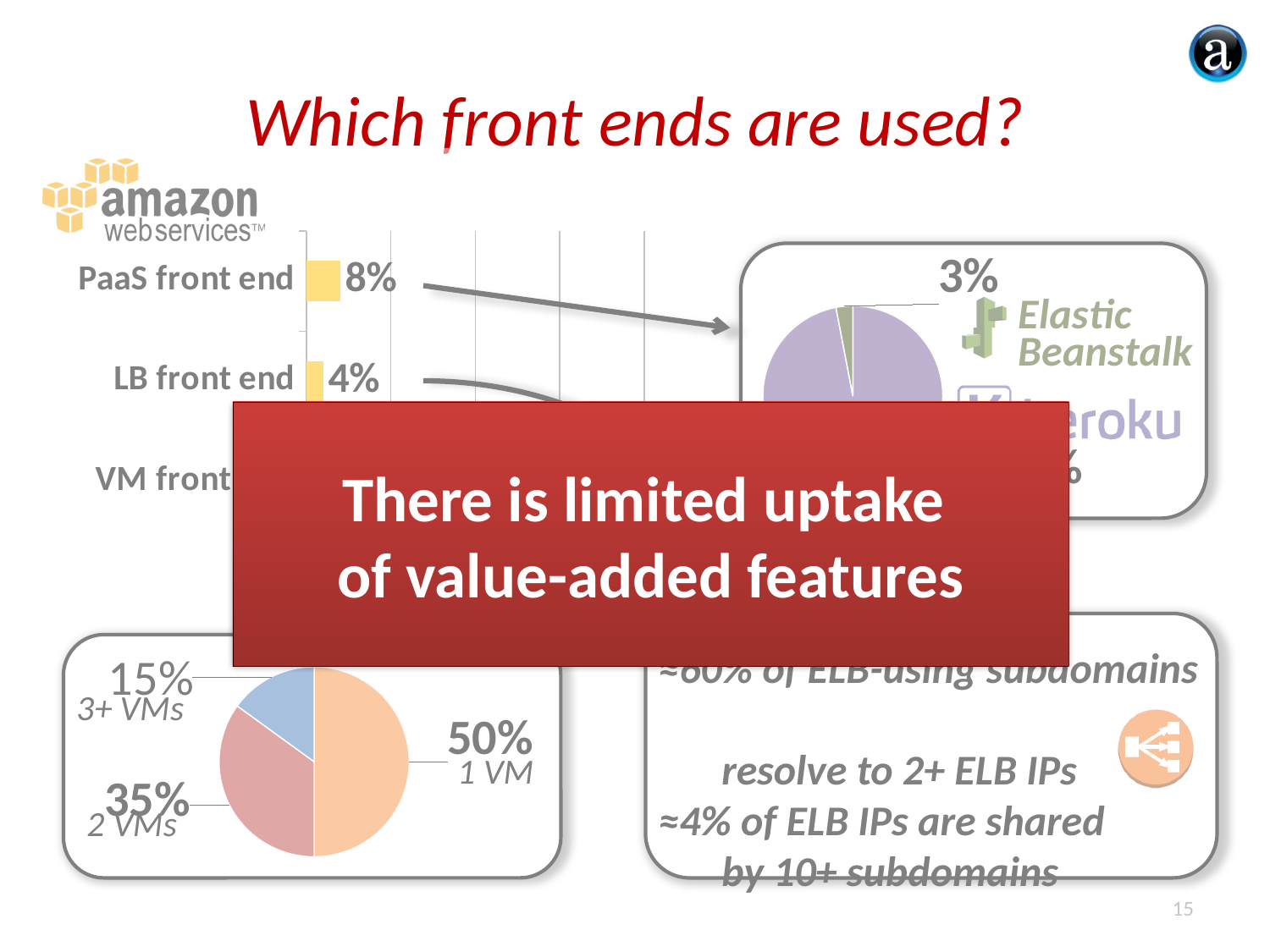
In the bar chart at the top left, which is larger, PaaS front end or LB front end? PaaS front end In the pie chart at the top right, what share is labelled for Elastic Beanstalk? 3% How many slices does the pie chart at the bottom left have? 3 In the pie chart at the bottom left, what share is labelled 3+ VMs? 15% In the pie chart at the bottom left, what share is labelled 1 VM? 50% In the pie chart at the bottom left, which slice is the smallest? 3+ VMs In the pie chart at the bottom left, which slice is the largest? 1 VM In the bar chart at the top left, what is the value for PaaS front end? 8% In the bar chart at the top left, what is the difference between the PaaS front end and LB front end values? 4% In the bar chart at the top left, what is the value for LB front end? 4% What kind of chart is the chart at the top left showing PaaS front end and LB front end? bar chart